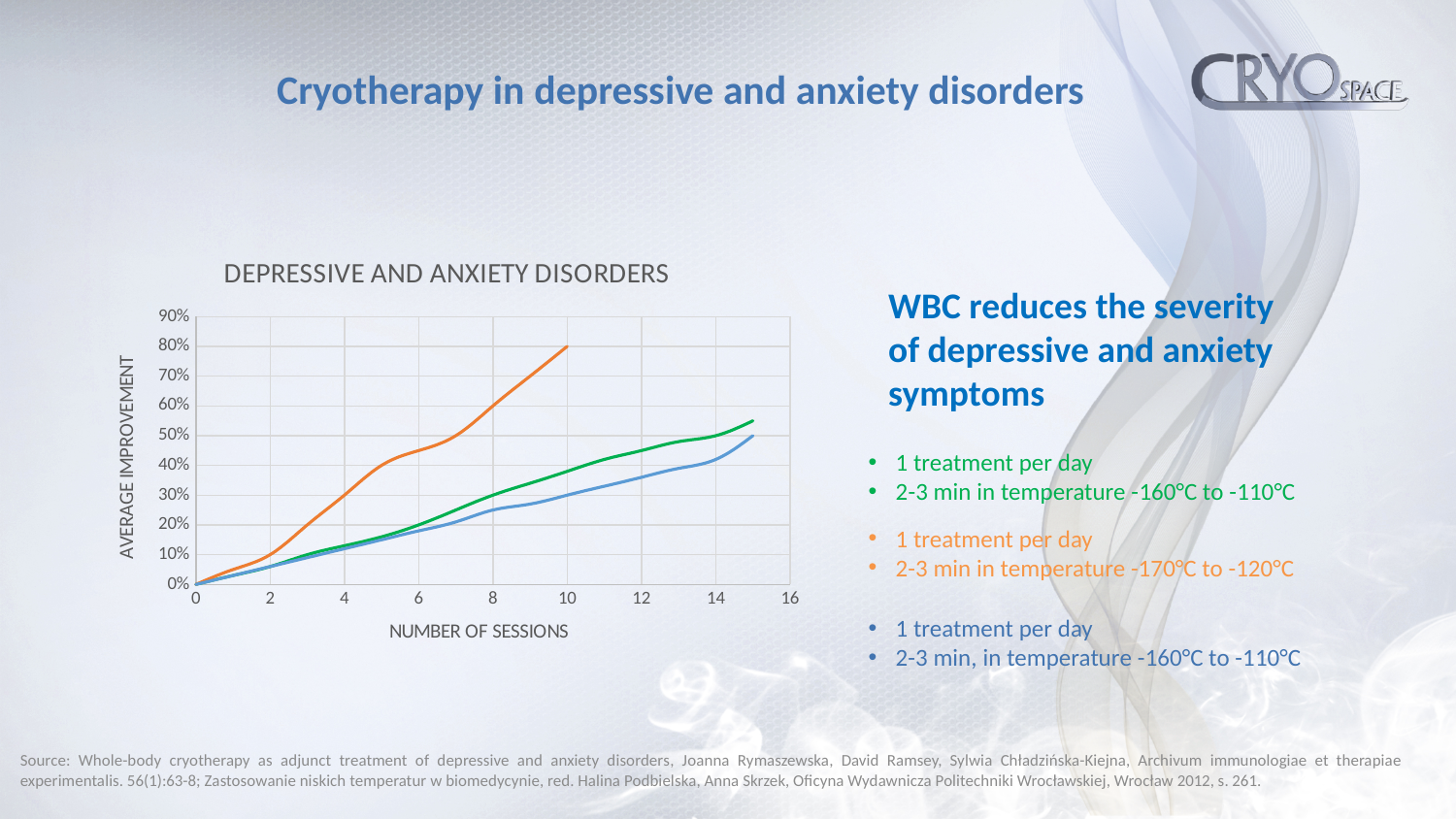
What is the highest value shown on the y axis of the chart? 90% Is the value of the orange line at 10 sessions greater or less than 70%? greater Do the values of the lines rise or fall as the number of sessions increases? rise Is the value of the orange line at 8 sessions greater or less than 50%? greater At 8 sessions, which line has the higher value, the orange line or the green line? orange line Which line reaches the highest average improvement on the chart? orange line How many lines are plotted on the chart? 3 What is the label of the x axis of the chart? NUMBER OF SESSIONS What is the title of the chart? DEPRESSIVE AND ANXIETY DISORDERS Is the value of the blue line at 14 sessions greater or less than 50%? less What kind of chart is shown on the slide? line chart